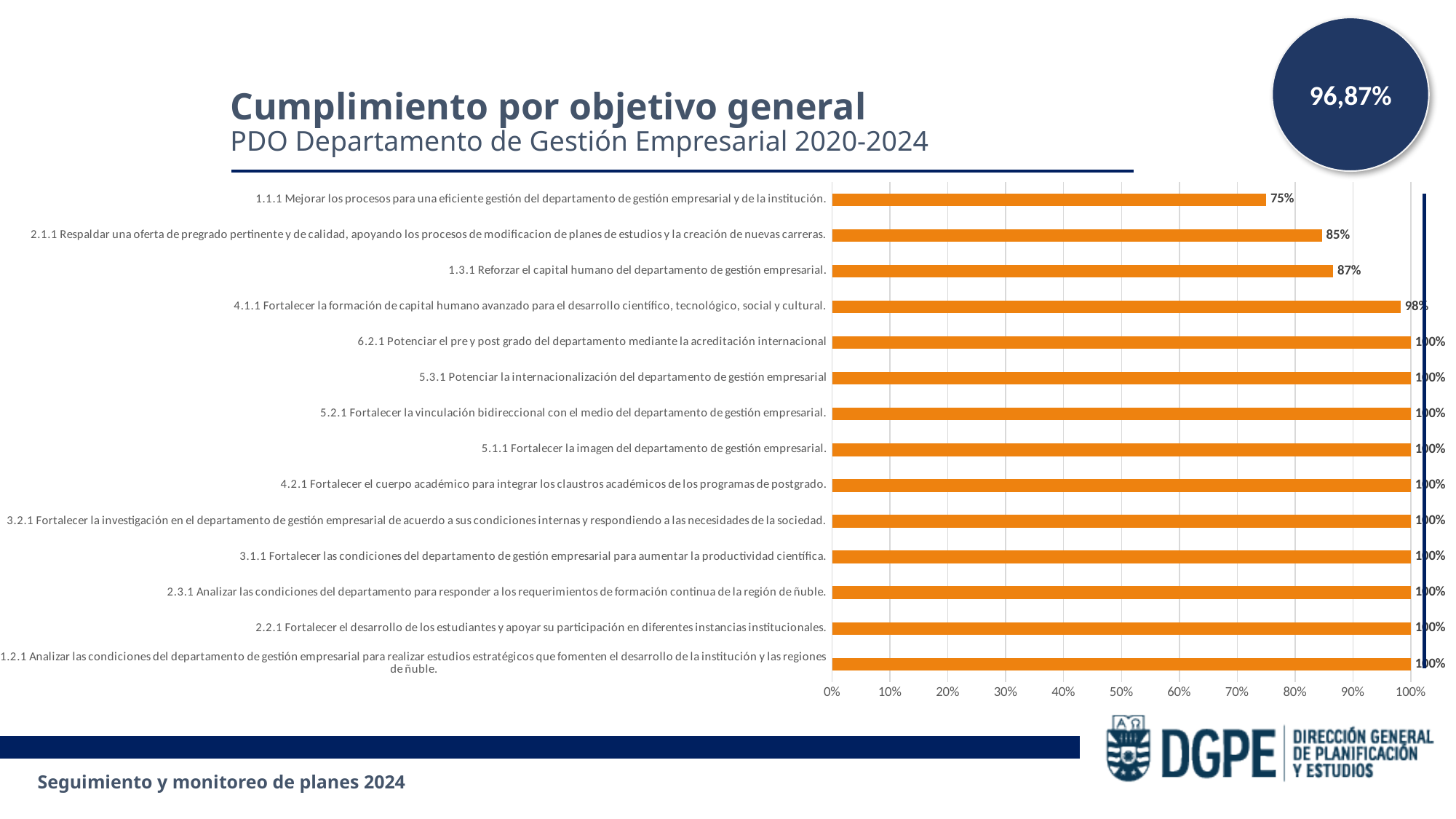
What is the value for objective 2.1.1 (Respaldar una oferta de pregrado pertinente y de calidad)? 85% What is the value for objective 4.1.1 (Fortalecer la formación de capital humano avanzado)? 98% What kind of chart is shown on the slide? Bar chart How many objectives (bars) are shown in the chart? 14 What is the difference between the values for objective 1.3.1 and objective 1.1.1? 12% What overall percentage is shown in the circle at the top right of the slide? 96,87% Which has a larger value, objective 2.1.1 or objective 1.3.1? 1.3.1 What is the difference between the values for objective 4.1.1 and objective 2.1.1? 13% What is the value for objective 1.1.1 (Mejorar los procesos para una eficiente gestión del departamento)? 75% What is the value for objective 1.3.1 (Reforzar el capital humano del departamento de gestión empresarial)? 87% Which objective has the lowest value in the chart? 1.1.1 Mejorar los procesos para una eficiente gestión del departamento de gestión empresarial y de la institución. How many objectives have a value of 100%? 10